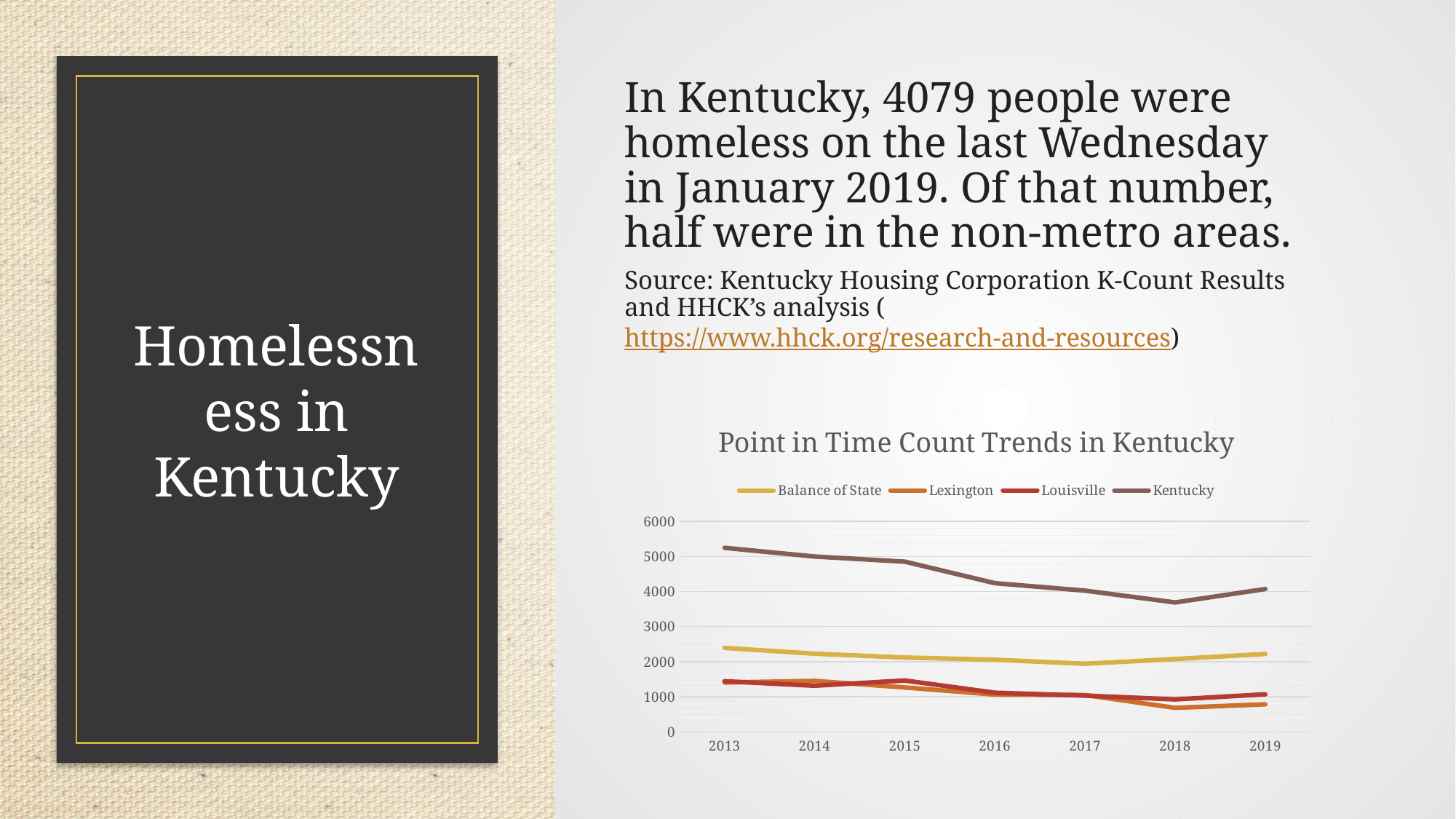
How many series does the legend of the chart list? 4 Does the Kentucky series rise or fall from 2013 to 2018? fall What kind of chart is shown on the slide? line chart In which year is the Kentucky series at its highest? 2013 What is the title of the chart? Point in Time Count Trends in Kentucky Which is larger in 2019, Balance of State or Louisville? Balance of State Is the value for Kentucky in 2013 greater or less than 5000? greater In which year is the Kentucky series at its lowest? 2018 How many years are shown on the x axis of the chart? 7 Is the value for Kentucky in 2018 greater or less than 4000? less Which series has the highest value in 2013? Kentucky Is the value for Lexington in 2018 greater or less than 1000? less